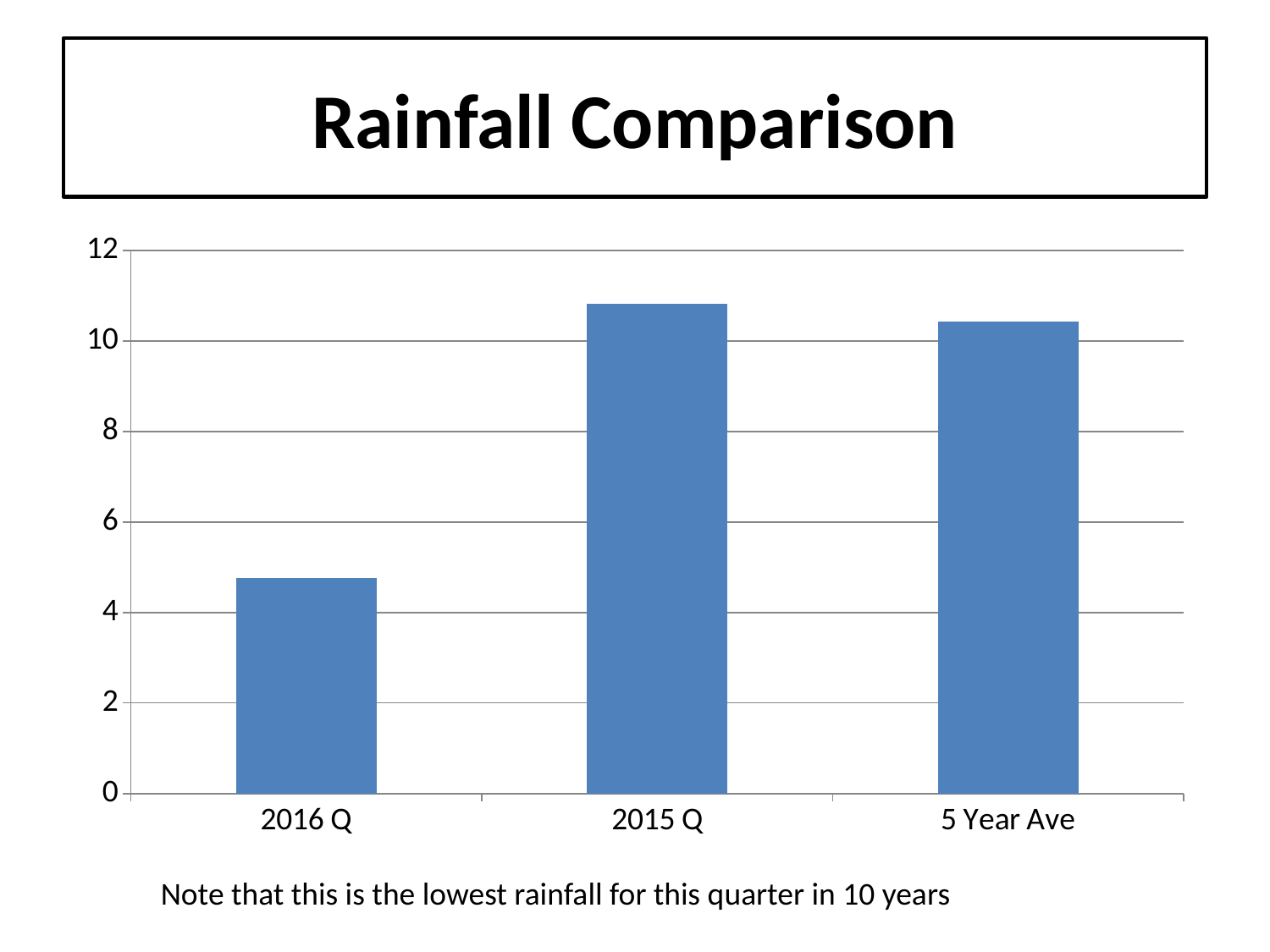
How many categories are plotted on the chart? 3 Is the value for 5 Year Ave greater or less than 10? greater Which is larger, the value for 2016 Q or the value for 2015 Q? 2015 Q Is the value for 2016 Q greater or less than 4? greater Which category has the lowest value? 2016 Q Which category has the highest value? 2015 Q What kind of chart is shown on the slide? bar chart What is the title of the slide? Rainfall Comparison Is the value for 2015 Q greater or less than 10? greater Which is larger, the value for 2016 Q or the value for 5 Year Ave? 5 Year Ave